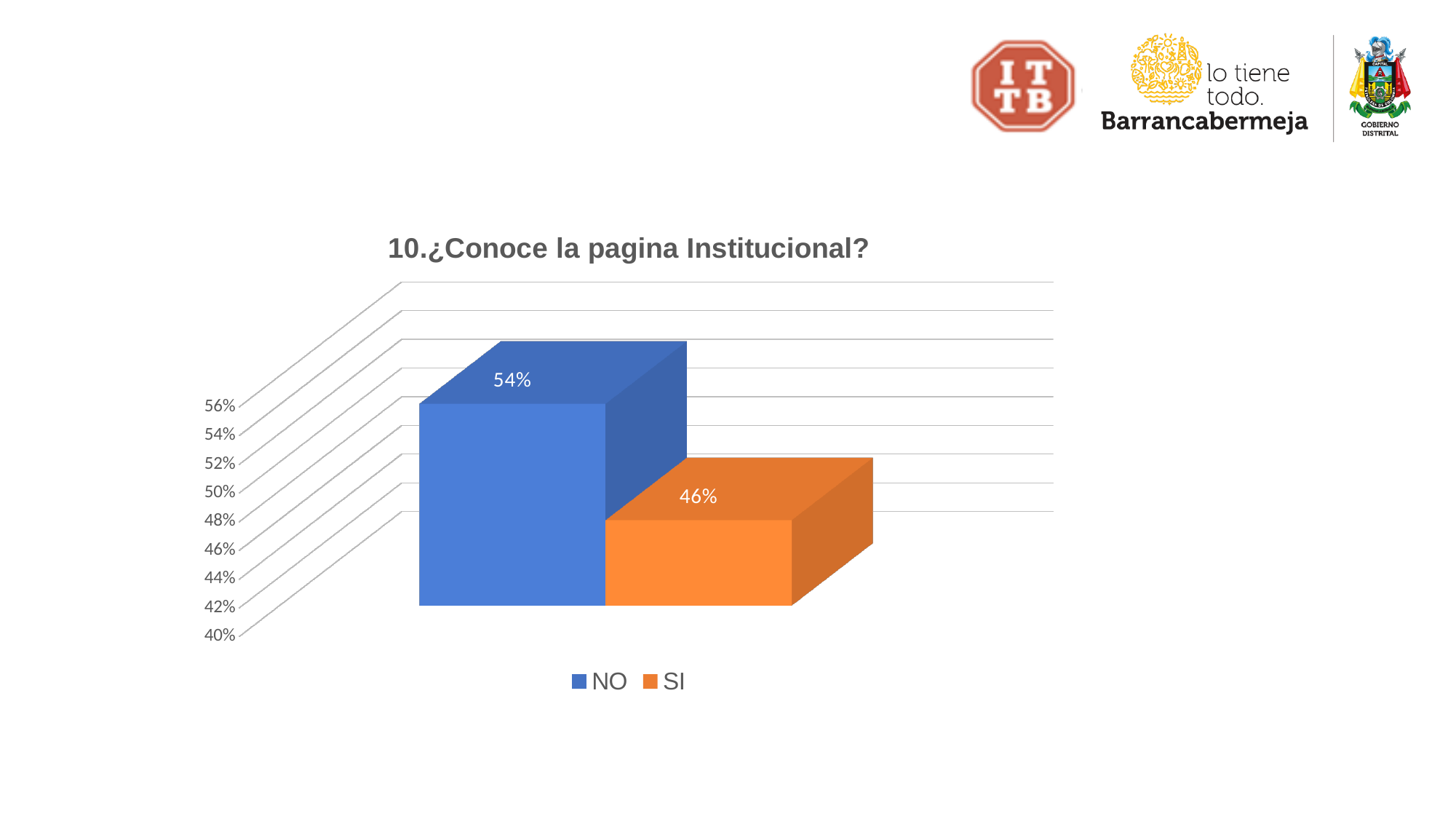
Which is larger, the value for NO or the value for SI? NO How many entries does the legend list? 2 What kind of chart is shown on the slide? bar chart What is the value for NO? 54% What is the value for SI? 46% What is the difference between the values for NO and SI? 8% Which category has the highest value? NO Is the value for SI greater or less than 50%? less How many categories are plotted in the chart? 2 Which category has the lowest value? SI Is the value for NO greater or less than 50%? greater What is the title of the chart? 10.¿Conoce la pagina Institucional?